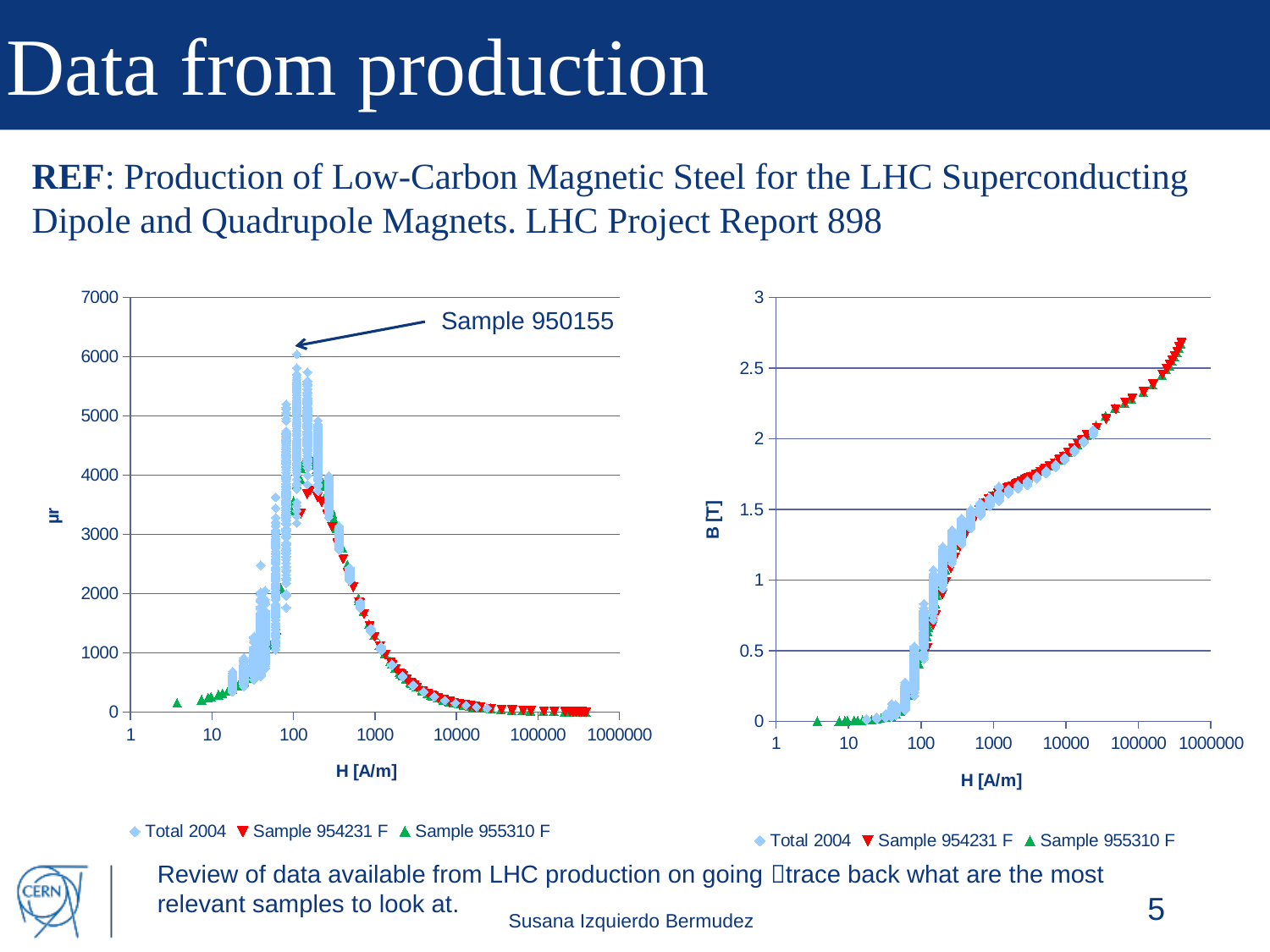
What is the y-axis title of the right chart? B [T] In the left chart, does μr rise or fall as H increases from 1000 to 1000000 A/m? fall How many series does the legend of the right chart list? 3 In the right chart, does B rise or fall as H increases along the x axis? rise What kind of chart is the right chart (B versus H)? scatter chart In the right chart, is the highest B value reached greater or less than 2.5? greater In the left chart, is the highest μr value reached by the Total 2004 series greater or less than 5000? greater Which sample does the arrow annotation in the left chart point to at the peak? Sample 950155 In the left chart, is the value of μr at H = 100000 A/m greater or less than 1000? less How many series does the legend of the left chart list? 3 What kind of chart is the left chart (μr versus H)? scatter chart